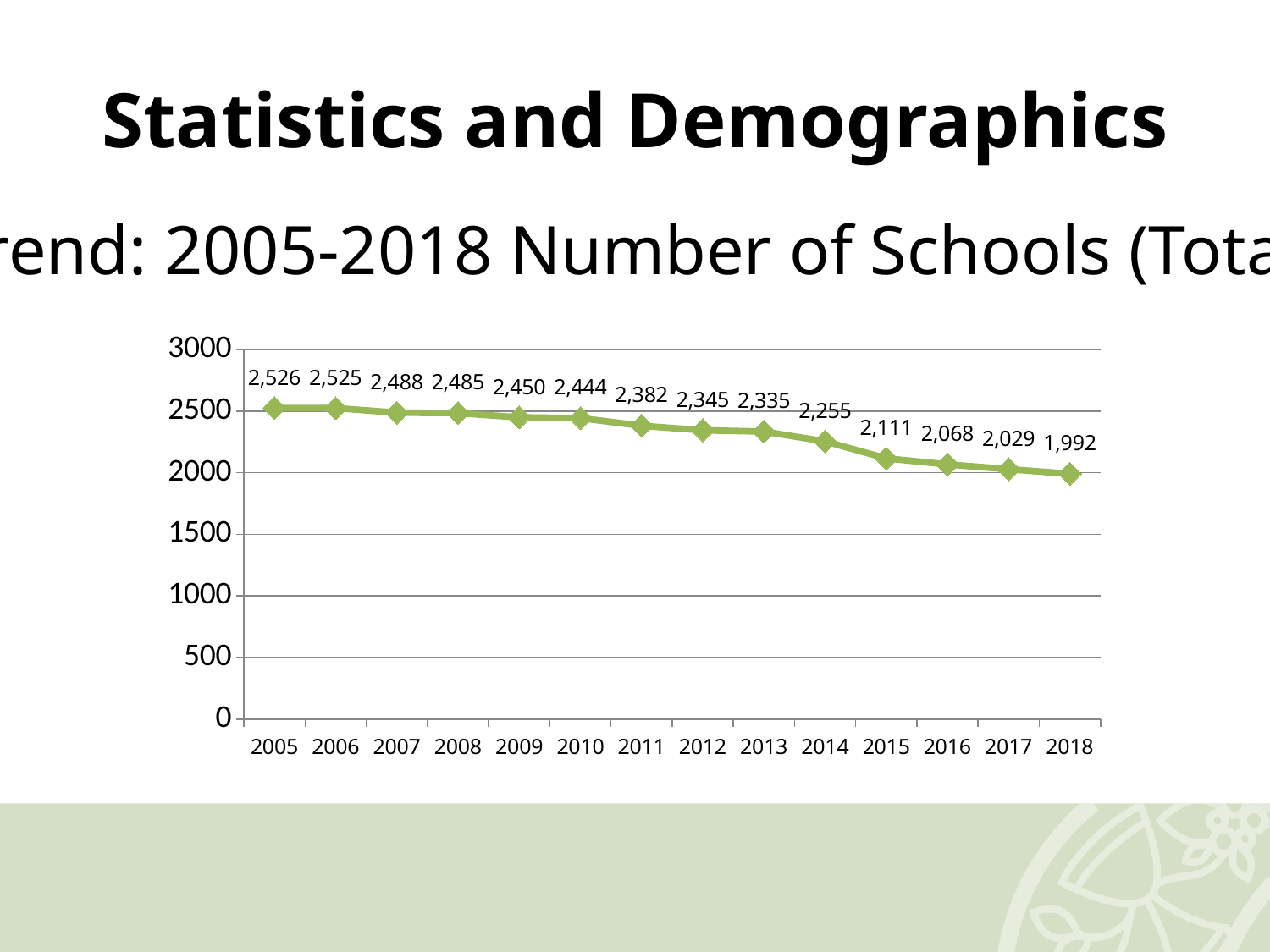
How many years are plotted on the chart? 14 Which year has the highest number of schools? 2005 What is the number of schools in 2014? 2,255 Which year has more schools, 2009 or 2013? 2009 Do the values rise or fall from 2005 to 2018? Fall What is the number of schools in 2018? 1,992 What is the difference between the number of schools in 2005 and 2018? 534 What kind of chart is shown on the slide? Line chart What is the number of schools in 2011? 2,382 What is the difference between the number of schools in 2014 and 2015? 144 What is the number of schools in 2005? 2,526 Which year has the lowest number of schools? 2018